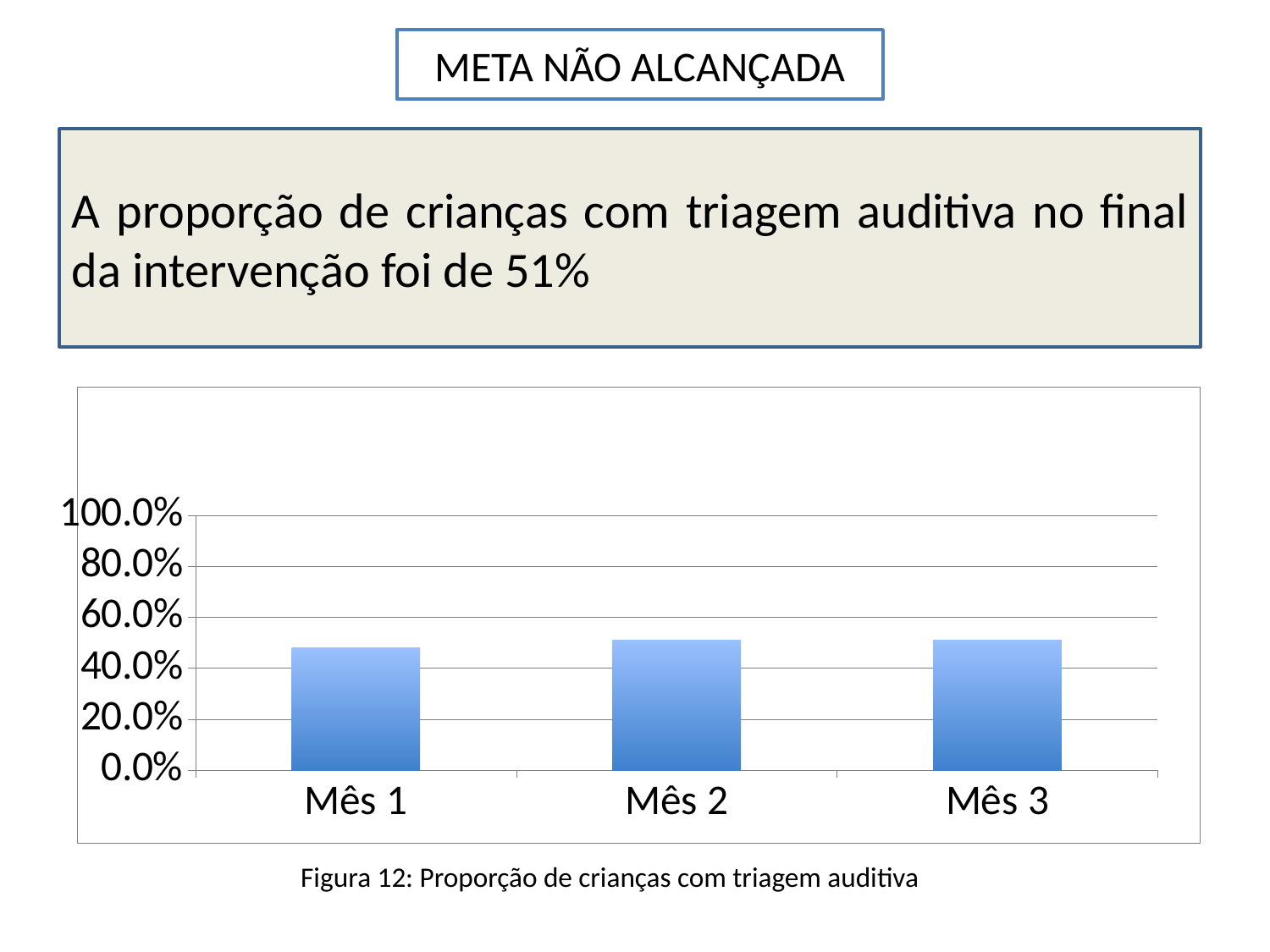
What is the caption of the figure below the chart? Figura 12: Proporção de crianças com triagem auditiva What is the label of the first category on the x axis? Mês 1 How many categories (months) are plotted on the x axis of the chart? 3 Is the value for Mês 1 greater or less than 40.0%? greater What kind of chart is shown on the slide? bar chart Is the value for Mês 3 greater or less than 80.0%? less Is the value for Mês 2 greater or less than 40.0%? greater What is the highest value shown on the y axis of the chart? 100.0%